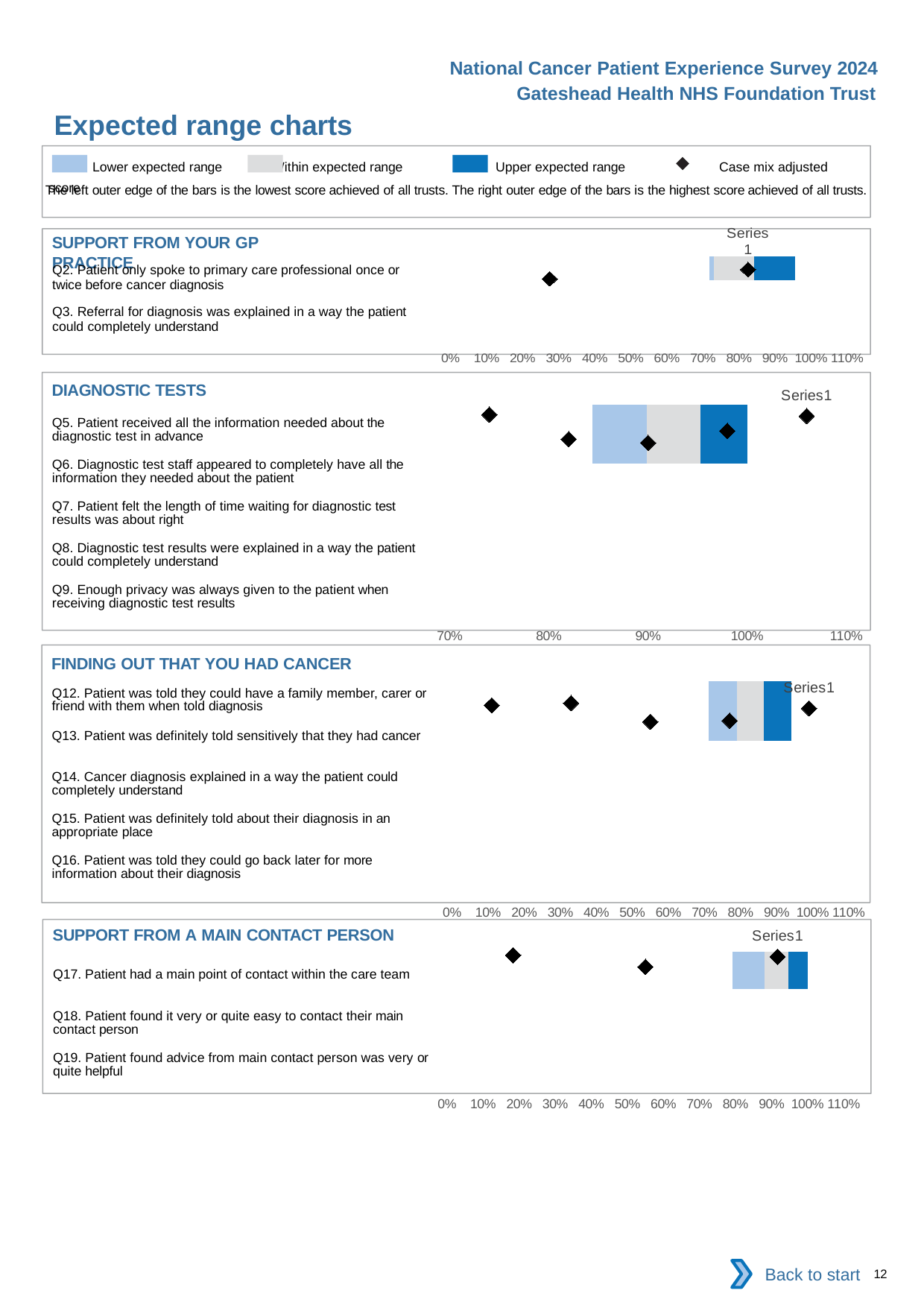
How many questions are listed in the SUPPORT FROM A MAIN CONTACT PERSON chart? 3 What is the lowest axis tick shown on the DIAGNOSTIC TESTS chart? 70% In the SUPPORT FROM YOUR GP PRACTICE chart, is the right edge of the expected range bar greater or less than 100%? less What kind of chart is the DIAGNOSTIC TESTS chart? Bar chart How many entries does the legend at the top of the slide list? 4 In the DIAGNOSTIC TESTS chart, is the left edge of the expected range bar greater or less than 80%? greater What is the highest axis tick shown on the SUPPORT FROM A MAIN CONTACT PERSON chart? 110% How many questions are listed in the SUPPORT FROM YOUR GP PRACTICE chart? 2 How many questions are listed in the DIAGNOSTIC TESTS chart? 5